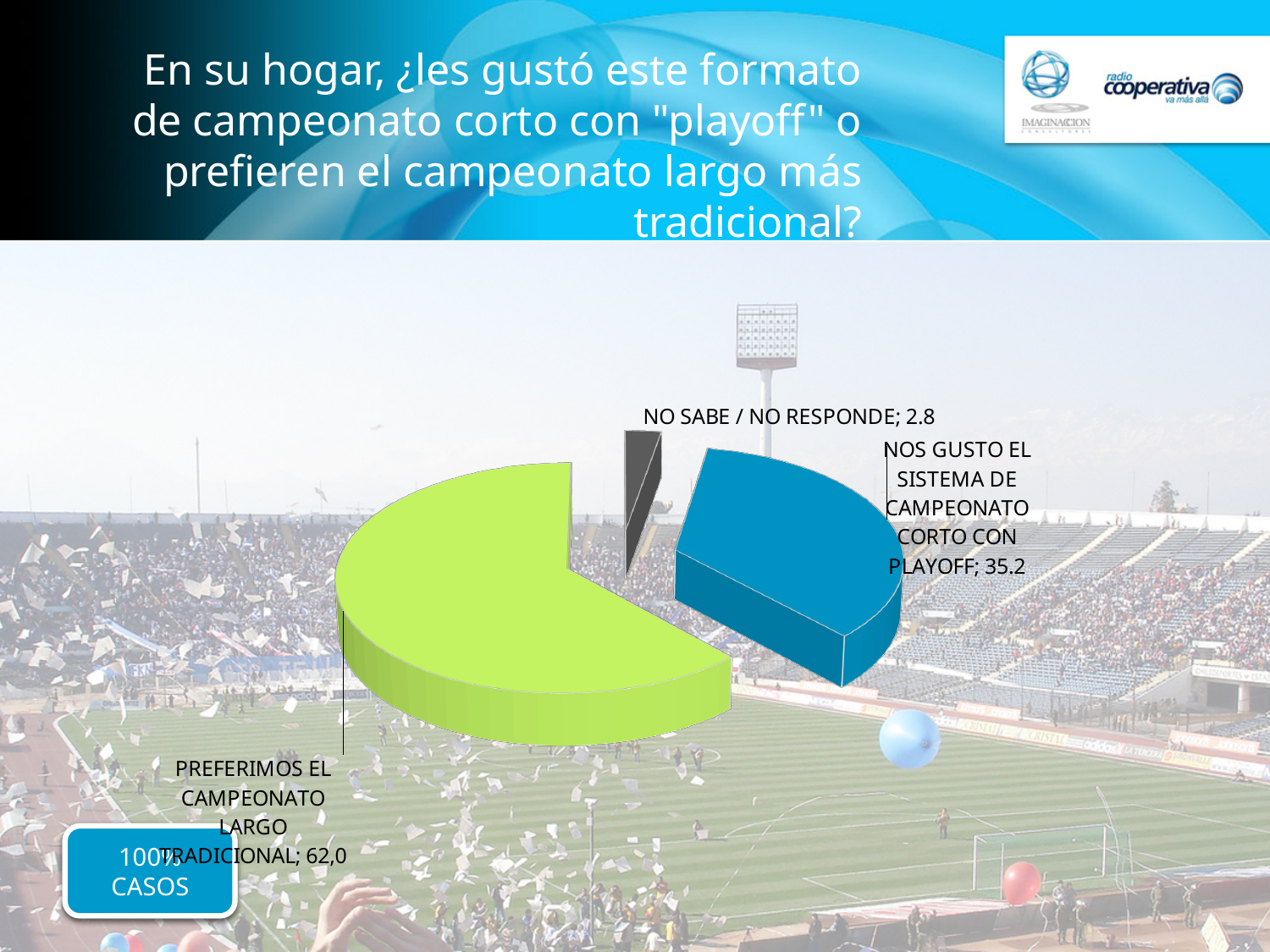
What is the value shown for "NO SABE / NO RESPONDE"? 2.8 What is the value shown for "NOS GUSTO EL SISTEMA DE CAMPEONATO CORTO CON PLAYOFF"? 35.2 What kind of chart is shown on the slide? pie chart What is the difference between the value for "NOS GUSTO EL SISTEMA DE CAMPEONATO CORTO CON PLAYOFF" and the value for "NO SABE / NO RESPONDE"? 32.4 Which is larger: the slice for the short championship with playoff or the slice for the traditional long championship? PREFERIMOS EL CAMPEONATO LARGO TRADICIONAL Which slice of the pie chart is the smallest? NO SABE / NO RESPONDE What is the value shown for "PREFERIMOS EL CAMPEONATO LARGO TRADICIONAL"? 62,0 What colour is the slice for "PREFERIMOS EL CAMPEONATO LARGO TRADICIONAL"? green How many cases does the box in the bottom-left corner of the slide say the survey is based on? 100 CASOS How many slices does the pie chart have? 3 What is the difference between the value for "PREFERIMOS EL CAMPEONATO LARGO TRADICIONAL" and the value for "NOS GUSTO EL SISTEMA DE CAMPEONATO CORTO CON PLAYOFF"? 26.8 Which slice of the pie chart is the largest? PREFERIMOS EL CAMPEONATO LARGO TRADICIONAL